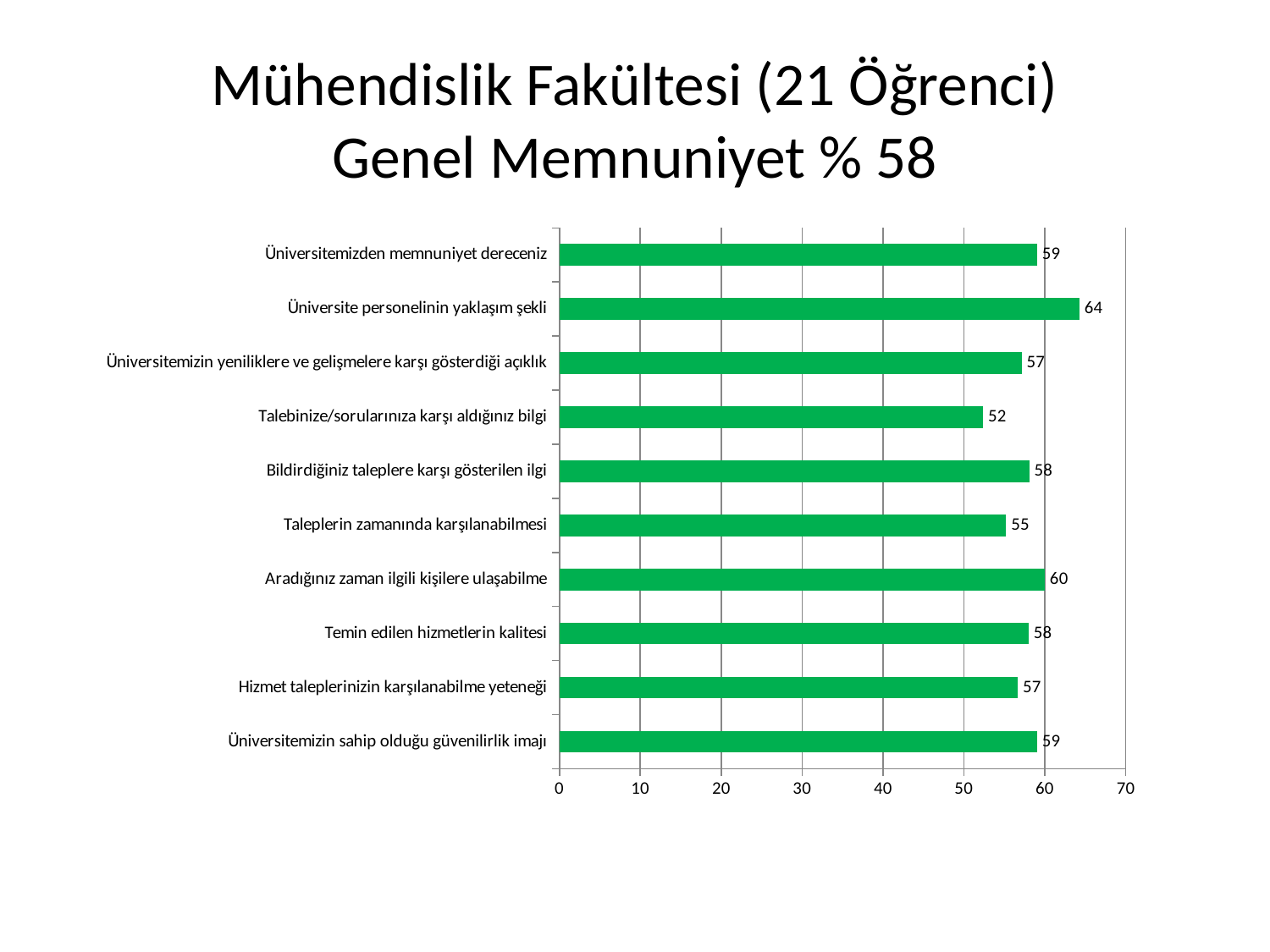
Which category has the lowest value? Talebinize/sorularınıza karşı aldığınız bilgi What is the value for "Talebinize/sorularınıza karşı aldığınız bilgi"? 52 Which category has the highest value? Üniversite personelinin yaklaşım şekli Is the value for "Üniversitemizden memnuniyet dereceniz" greater or less than 50? greater How many categories are shown in the chart? 10 What kind of chart is shown on the slide? bar chart What is the title of the slide? Mühendislik Fakültesi (21 Öğrenci) Genel Memnuniyet % 58 What is the difference between the values for "Üniversite personelinin yaklaşım şekli" and "Talebinize/sorularınıza karşı aldığınız bilgi"? 12 What is the value for "Aradığınız zaman ilgili kişilere ulaşabilme"? 60 What is the value for "Üniversite personelinin yaklaşım şekli"? 64 Which is larger: the value for "Aradığınız zaman ilgili kişilere ulaşabilme" or the value for "Taleplerin zamanında karşılanabilmesi"? Aradığınız zaman ilgili kişilere ulaşabilme What is the value for "Taleplerin zamanında karşılanabilmesi"? 55